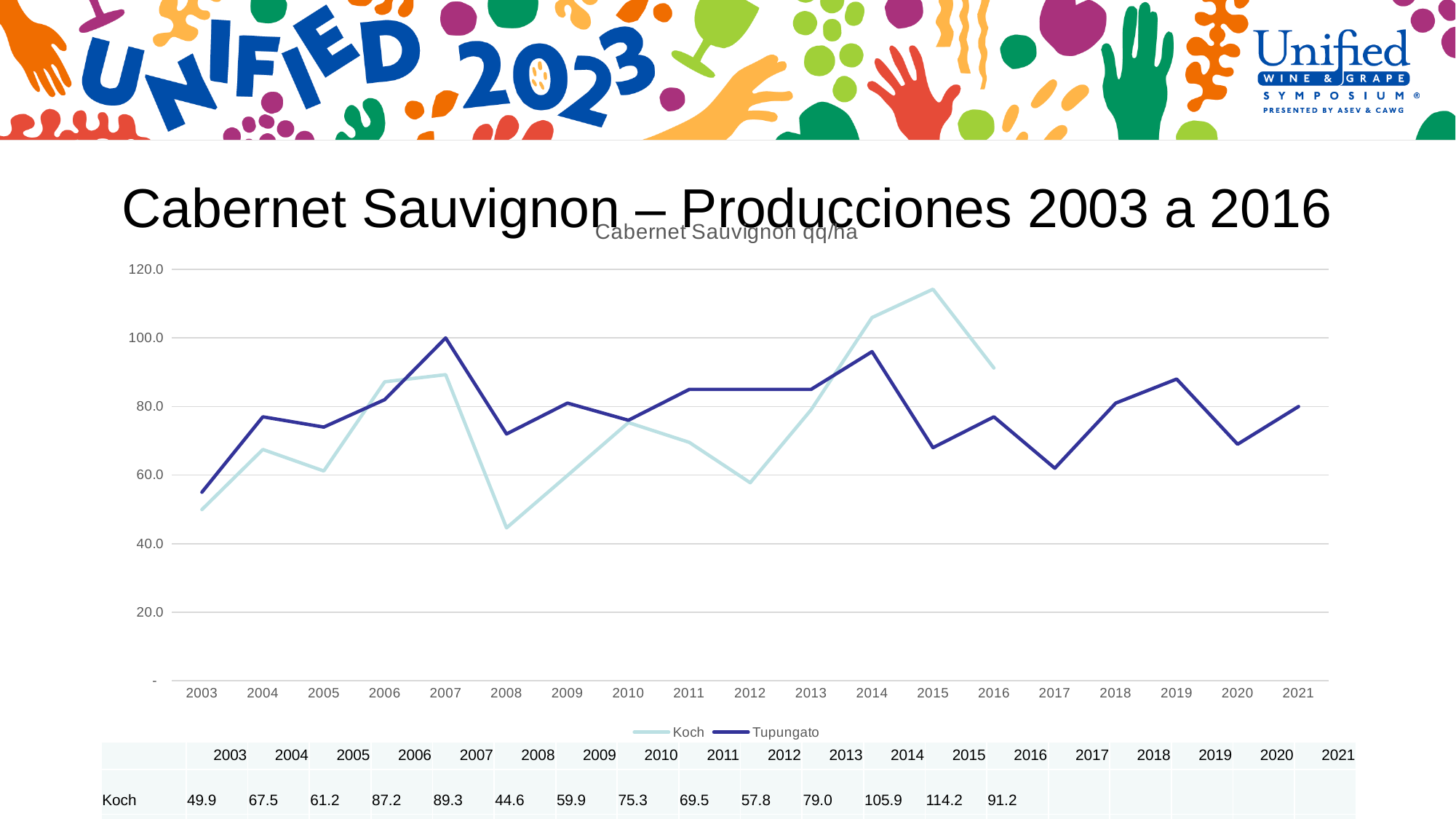
Is the Tupungato value for 2017 greater or less than 80? less What is the difference between the Koch values for 2015 and 2014? 8.3 What is the Koch value for 2003? 49.9 Which is larger, the Koch value for 2007 or for 2006? 2007 What is the Koch value for 2008? 44.6 What is the Koch value for 2015? 114.2 In which year is the Koch series lowest? 2008 What kind of chart is shown? line chart In which year is the Koch series highest? 2015 How many series does the legend list? 2 Does the Koch series rise or fall from 2013 to 2015? rise Is the Tupungato value for 2007 greater or less than 80? greater